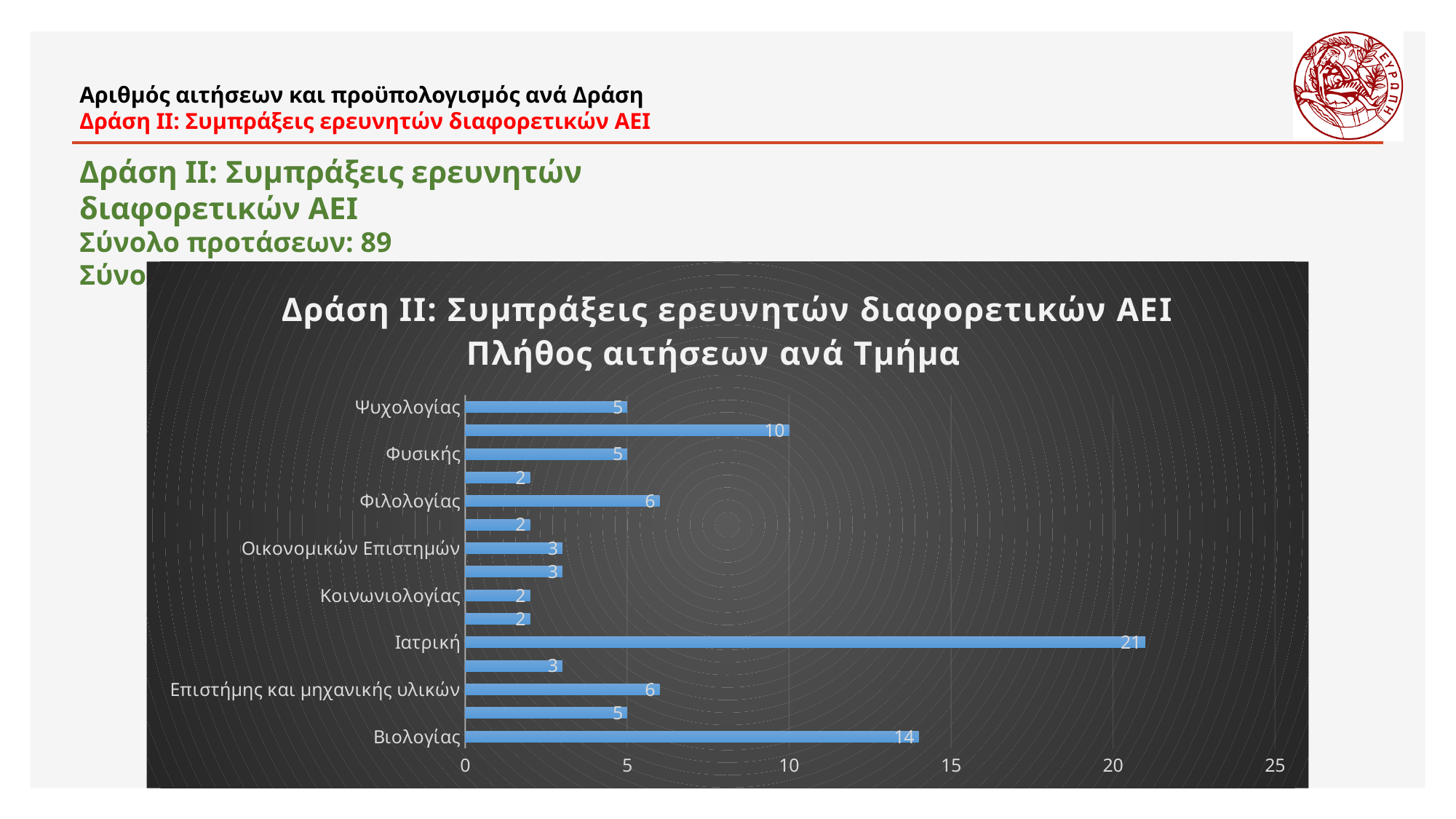
What is the difference between the values for Ιατρική and Βιολογίας? 7 What is the value for Κοινωνιολογίας? 2 What is the value for Ιατρική? 21 What is the value for Οικονομικών Επιστημών? 3 What is the value for Βιολογίας? 14 What type of chart is shown on the slide? bar chart Which is larger, the value for Βιολογίας or the value for Φυσικής? Βιολογίας What is the value for Φιλολογίας? 6 Which labelled department has the highest number of applications? Ιατρική What is the second line of the chart title? Πλήθος αιτήσεων ανά Τμήμα Is the value for Ιατρική greater or less than 20? greater What is the value for Επιστήμης και μηχανικής υλικών? 6